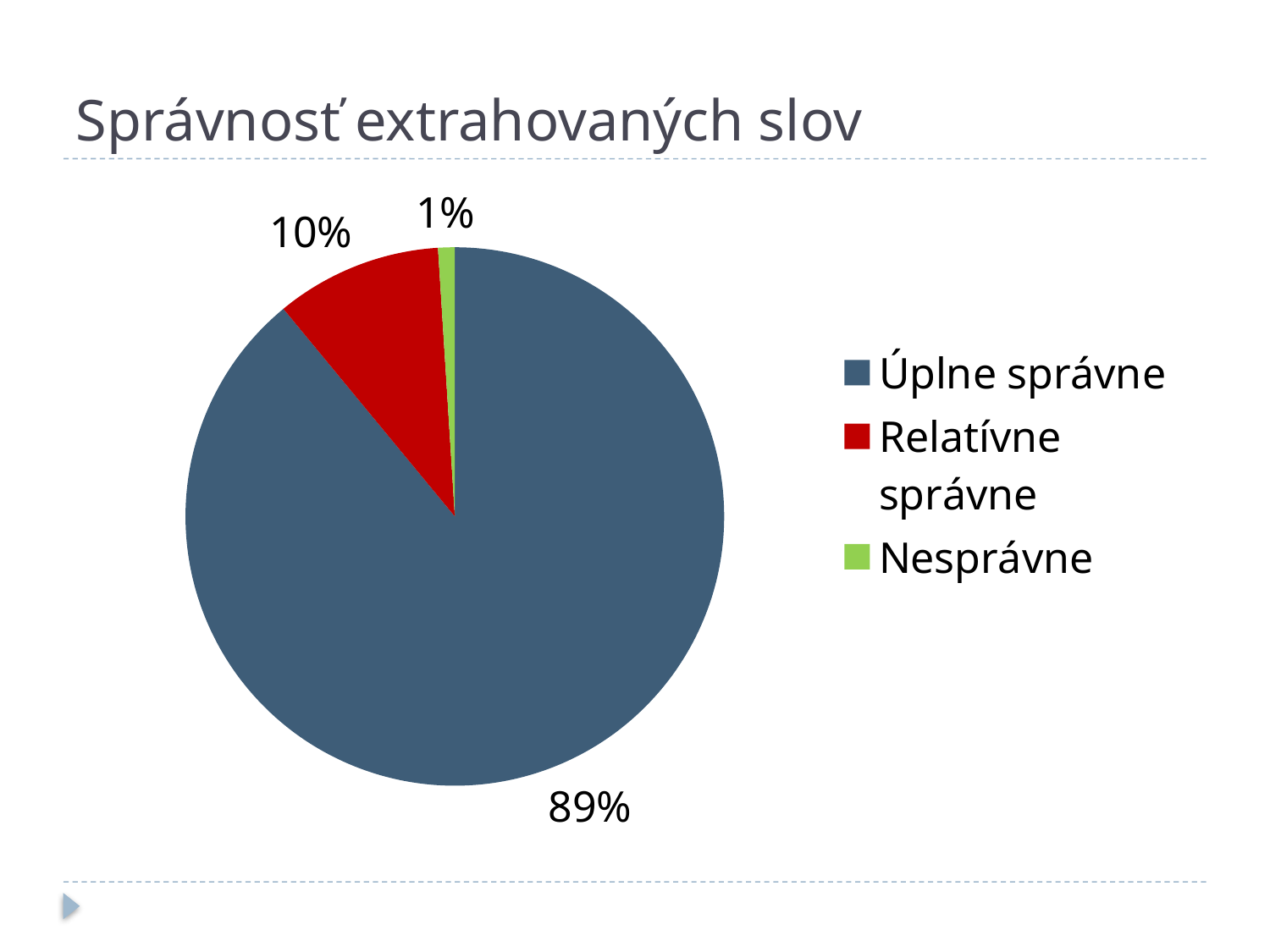
What share of the pie does "Relatívne správne" have? 10% How many entries does the legend list? 3 What kind of chart is shown on the slide? pie chart Which category has the largest slice of the pie? Úplne správne Which is larger, the share of "Relatívne správne" or the share of "Nesprávne"? Relatívne správne What share of the pie does "Úplne správne" have? 89% What colour is the slice for "Nesprávne"? green Which category has the smallest slice of the pie? Nesprávne What share of the pie does "Nesprávne" have? 1% What is the difference between the shares of "Úplne správne" and "Relatívne správne"? 79% How many slices does the pie chart have? 3 What is the title of the slide containing the pie chart? Správnosť extrahovaných slov